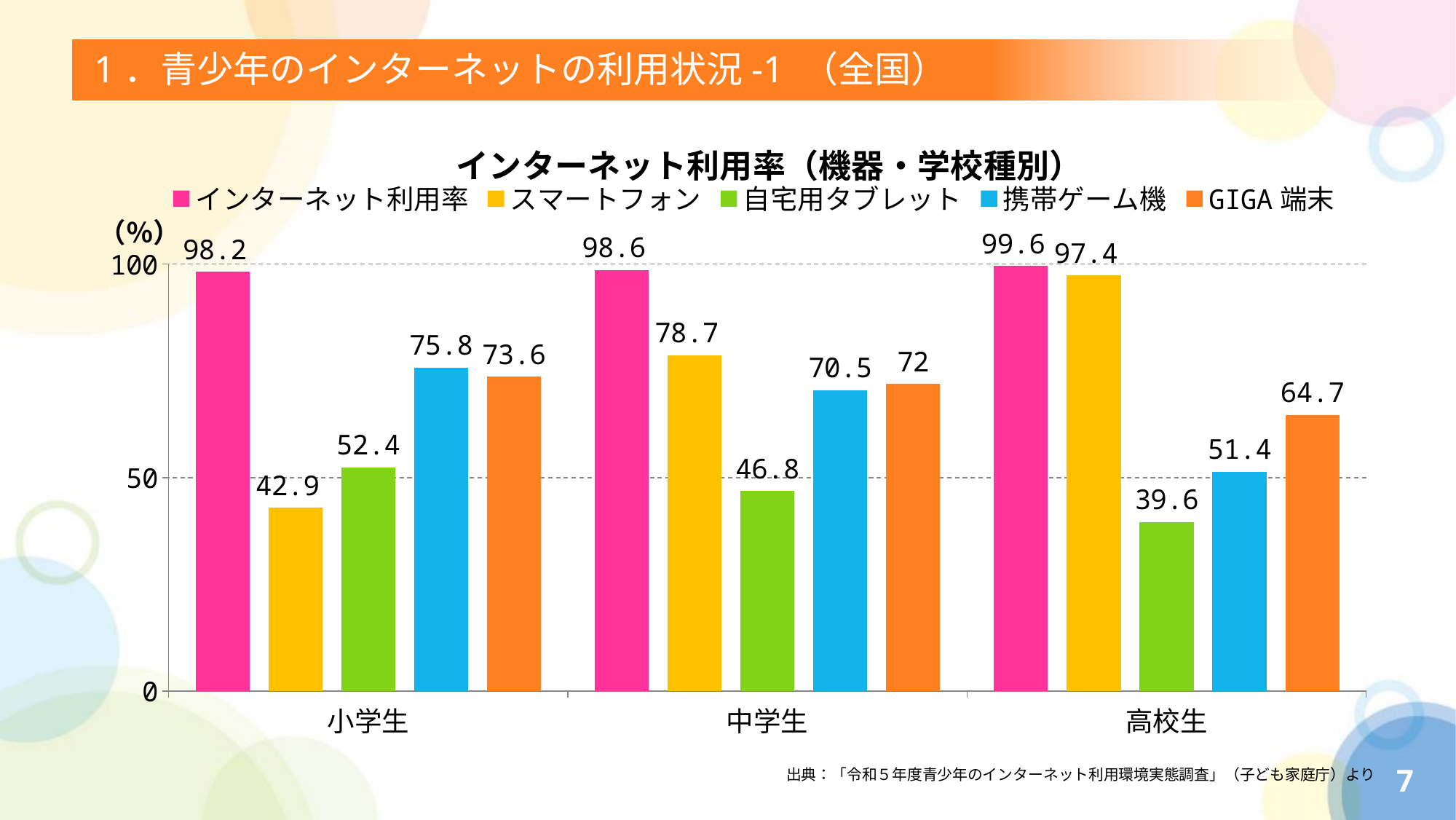
What kind of chart is shown? bar chart What is the GIGA 端末 value for 高校生? 64.7 What is the difference between the スマートフォン values for 高校生 and 小学生? 54.5 What is the スマートフォン value for 小学生? 42.9 Is the 自宅用タブレット value for 中学生 greater or less than 50? less How many series does the legend list? 5 What is the title of the chart? インターネット利用率（機器・学校種別） Which is larger for 中学生: 携帯ゲーム機 or GIGA 端末? GIGA 端末 Which school category has the highest インターネット利用率? 高校生 What is the 携帯ゲーム機 value for 中学生? 70.5 Which school category has the lowest 自宅用タブレット value? 高校生 How many school categories are shown on the x axis? 3